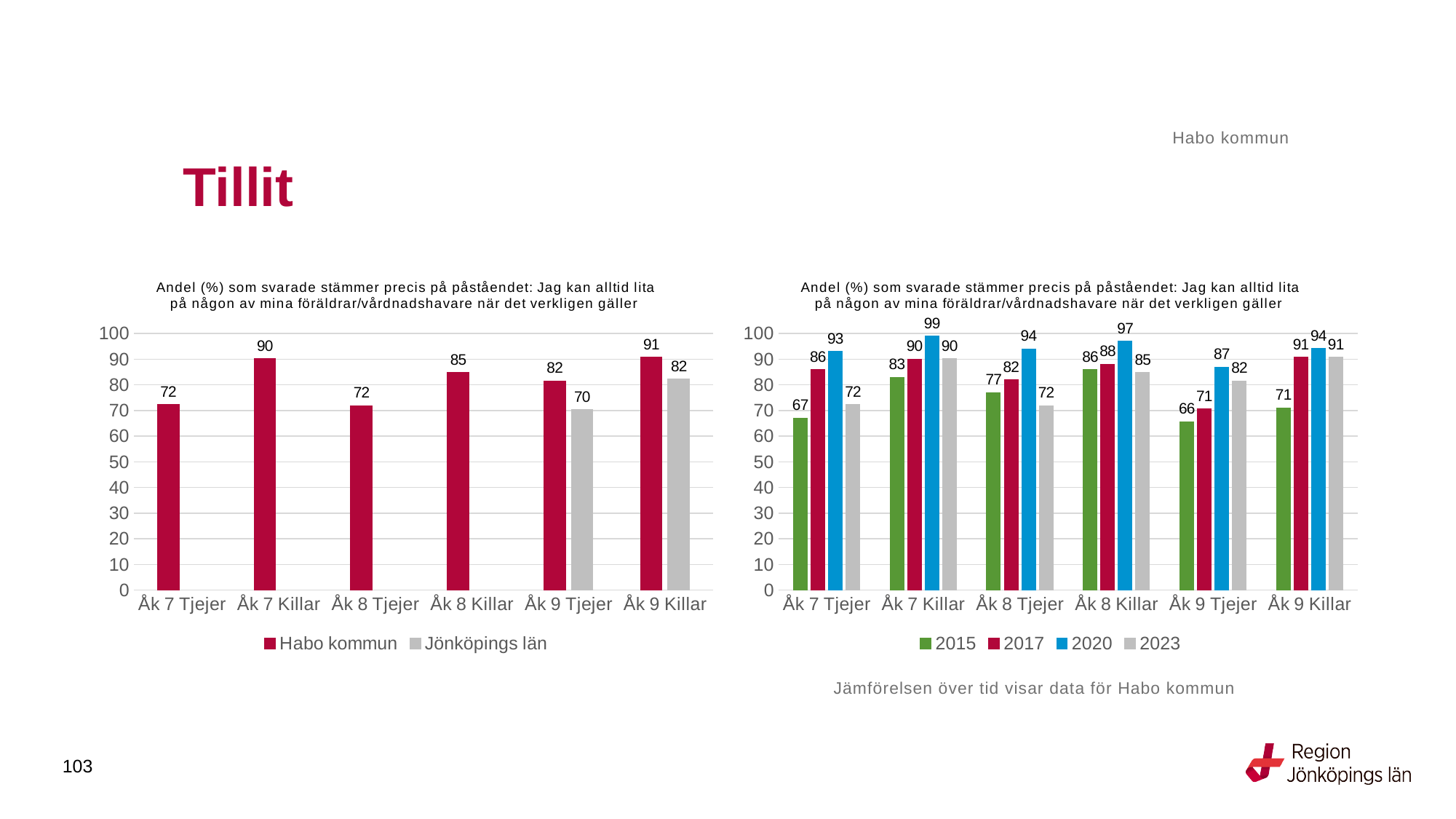
In the left chart, what is the difference between Habo kommun and Jönköpings län for Åk 9 Tjejer? 12 In the right chart, which year does the blue series represent? 2020 In the left chart, how many categories are shown on the x axis? 6 In the right chart, what is the difference between the 2020 and 2023 values for Åk 8 Tjejer? 22 In the left chart, how many series does the legend list? 2 What type of chart is the right chart? Bar chart In the right chart, which is larger for Åk 8 Tjejer: 2017 or 2023? 2017 In the right chart, how many series does the legend list? 4 In the right chart, what is the value for 2020 for Åk 7 Killar? 99 In the right chart, which category has the lowest value for 2015? Åk 9 Tjejer In the left chart, what is the value for Habo kommun for Åk 8 Killar? 85 In the left chart, which category has the highest value for Habo kommun? Åk 9 Killar